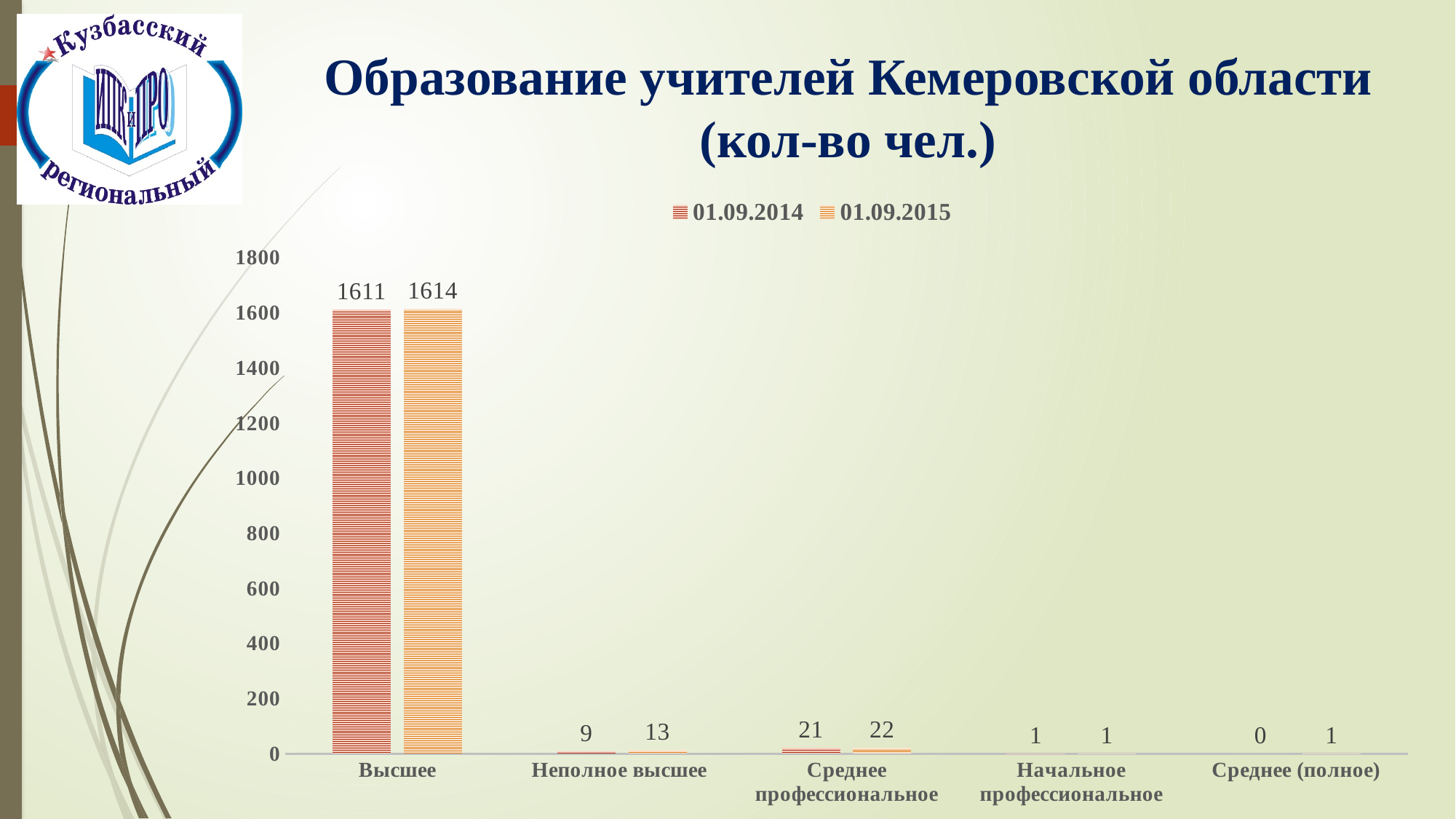
What is the value for Высшее in the 01.09.2015 series? 1614 Which category has the lowest value in the 01.09.2014 series? Среднее (полное) Which category has the highest value in the 01.09.2015 series? Высшее What is the difference between the 01.09.2015 and 01.09.2014 values for Неполное высшее? 4 What is the value for Высшее in the 01.09.2014 series? 1611 How many series does the legend list? 2 What is the value for Неполное высшее in the 01.09.2015 series? 13 What is the value for Среднее (полное) in the 01.09.2014 series? 0 What is the value for Среднее профессиональное in the 01.09.2014 series? 21 Which is larger for Среднее профессиональное: the 01.09.2014 value or the 01.09.2015 value? 01.09.2015 How many categories are shown on the x axis? 5 What kind of chart is shown on the slide? bar chart